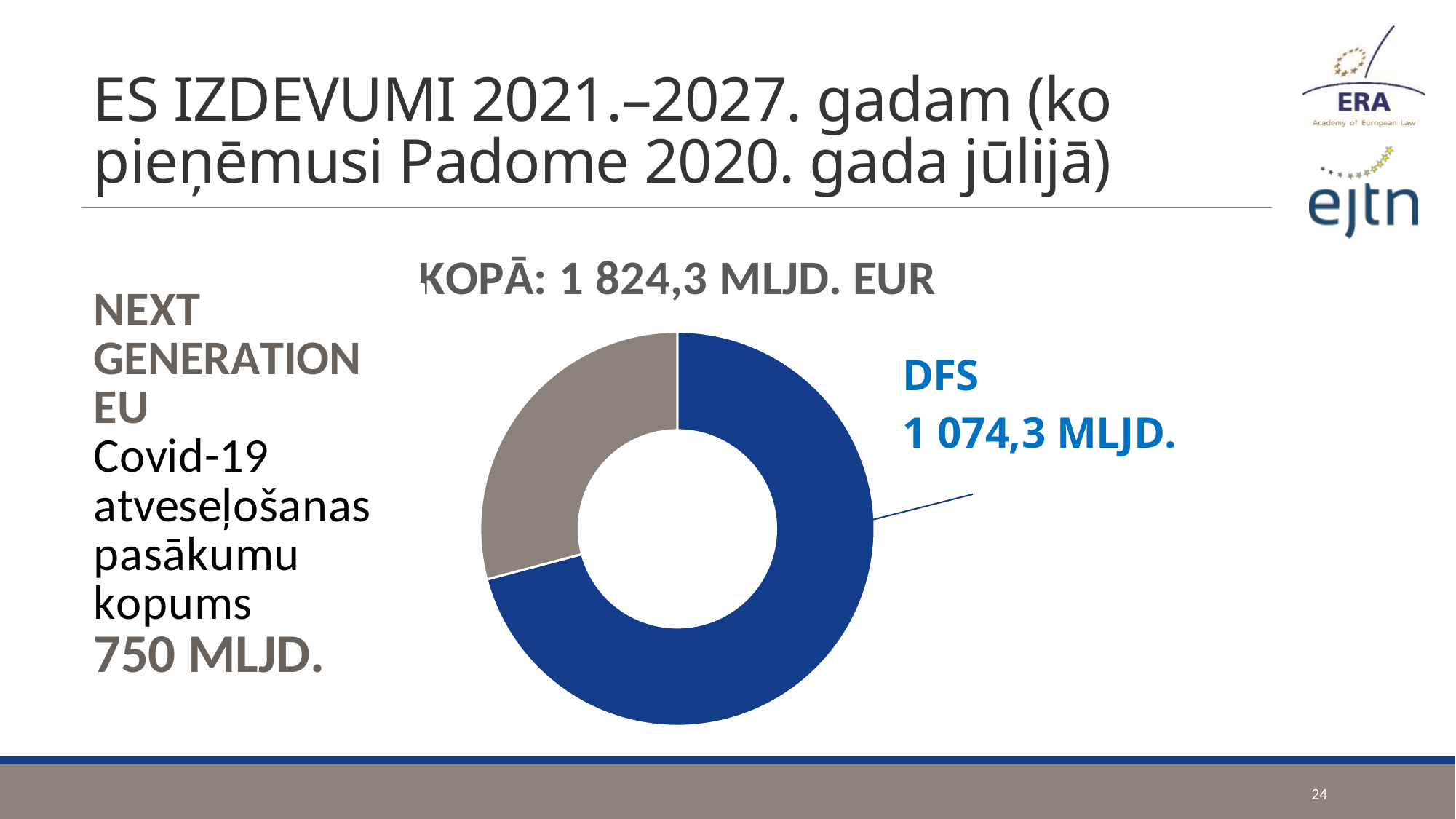
What is the value shown for DFS in the doughnut chart? 1 074,3 MLJD. What colour is the DFS segment of the doughnut chart? Blue Which segment of the doughnut chart is the smallest? Next Generation EU What is the difference between the DFS value and the Next Generation EU value? 324,3 MLJD. How many segments does the doughnut chart have? 2 What total is stated above the doughnut chart? 1 824,3 MLJD. EUR What colour is the Next Generation EU segment of the doughnut chart? Grey What kind of chart is shown on the slide? Doughnut chart Does DFS account for more or less than half of the total? More than half What is the value shown for Next Generation EU (Covid-19 atveseļošanas pasākumu kopums)? 750 MLJD. Which is larger, DFS or Next Generation EU? DFS Which segment of the doughnut chart is the largest? DFS